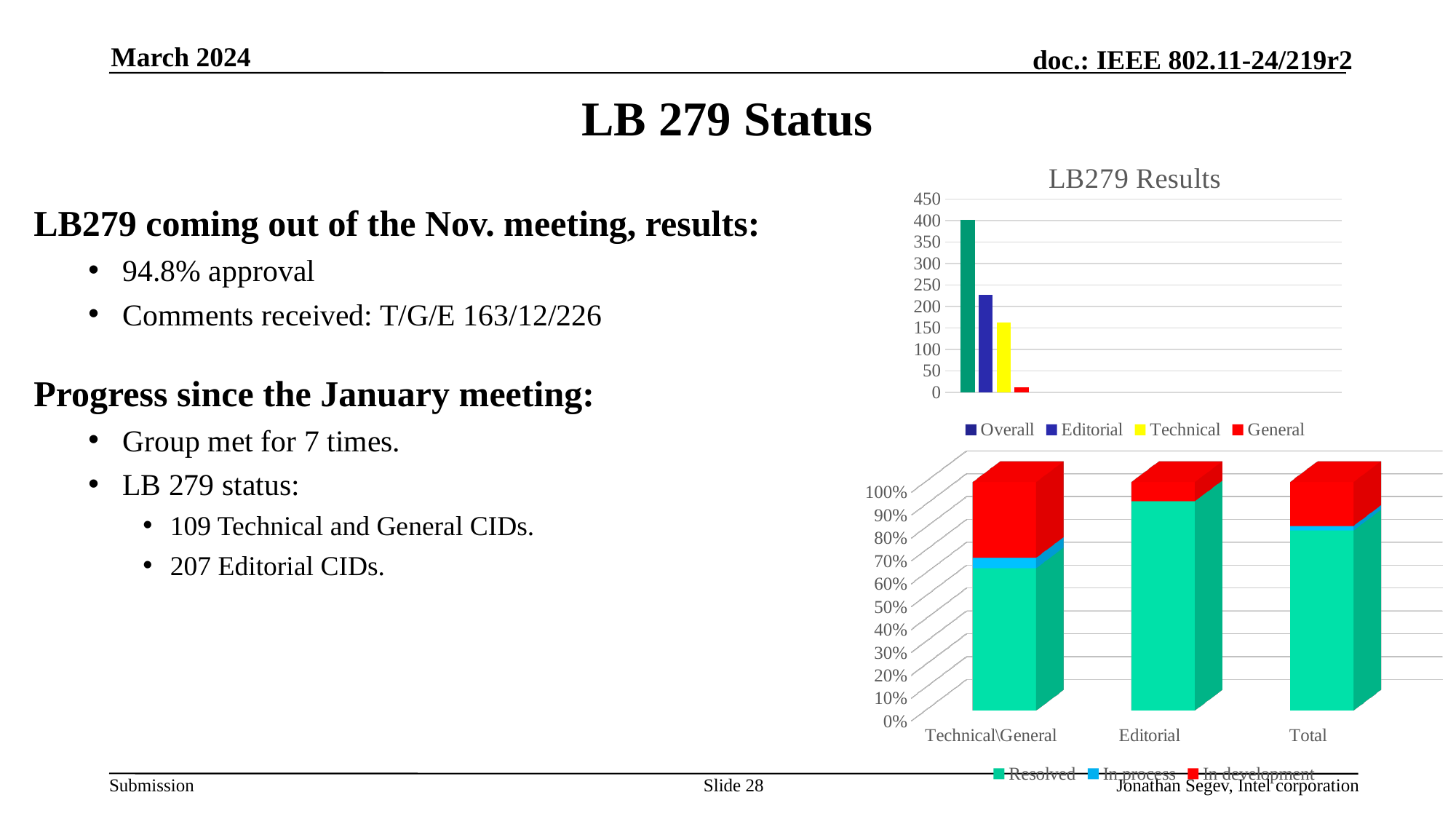
In the bottom stacked bar chart, which category has the largest Resolved share, Technical\General or Editorial? Editorial How many categories are shown on the x axis of the bottom stacked bar chart? 3 In the 'LB279 Results' chart, is the value for Technical greater or less than 200? less In the 'LB279 Results' chart, is the value for General greater or less than 50? less In the bottom stacked bar chart, is the Resolved share for Technical\General greater or less than 50%? greater In the 'LB279 Results' chart, which is larger, Editorial or Technical? Editorial In the 'LB279 Results' chart, which series has the highest value? Overall How many series does the legend of the bottom stacked bar chart list? 3 How many series does the legend of the 'LB279 Results' chart list? 4 In the 'LB279 Results' chart, which series has the lowest value? General What type of chart is the 'LB279 Results' chart? bar chart